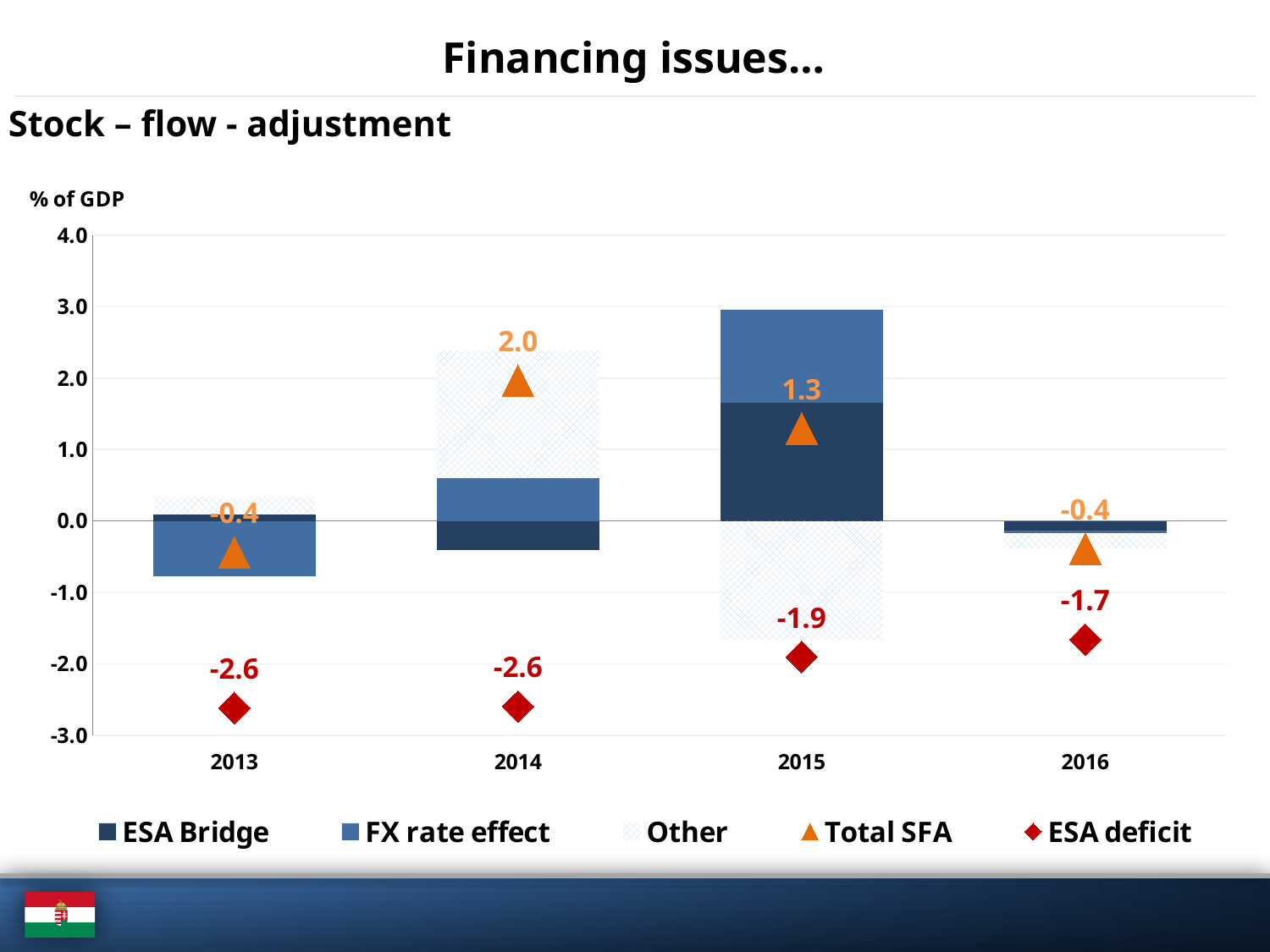
How many series does the legend list? 5 What is the ESA deficit value for 2015? -1.9 How many years are shown on the x axis? 4 Does the ESA deficit rise or fall from 2013 to 2016? rise What is the ESA deficit value for 2013? -2.6 What is the Total SFA value for 2014? 2.0 Which year has the larger Total SFA, 2013 or 2015? 2015 What is the difference between the ESA deficit values for 2013 and 2016? 0.9 What is the difference between the Total SFA values for 2014 and 2015? 0.7 What is the Total SFA value for 2016? -0.4 In which year is the ESA deficit value highest (least negative)? 2016 In which year is the Total SFA highest? 2014